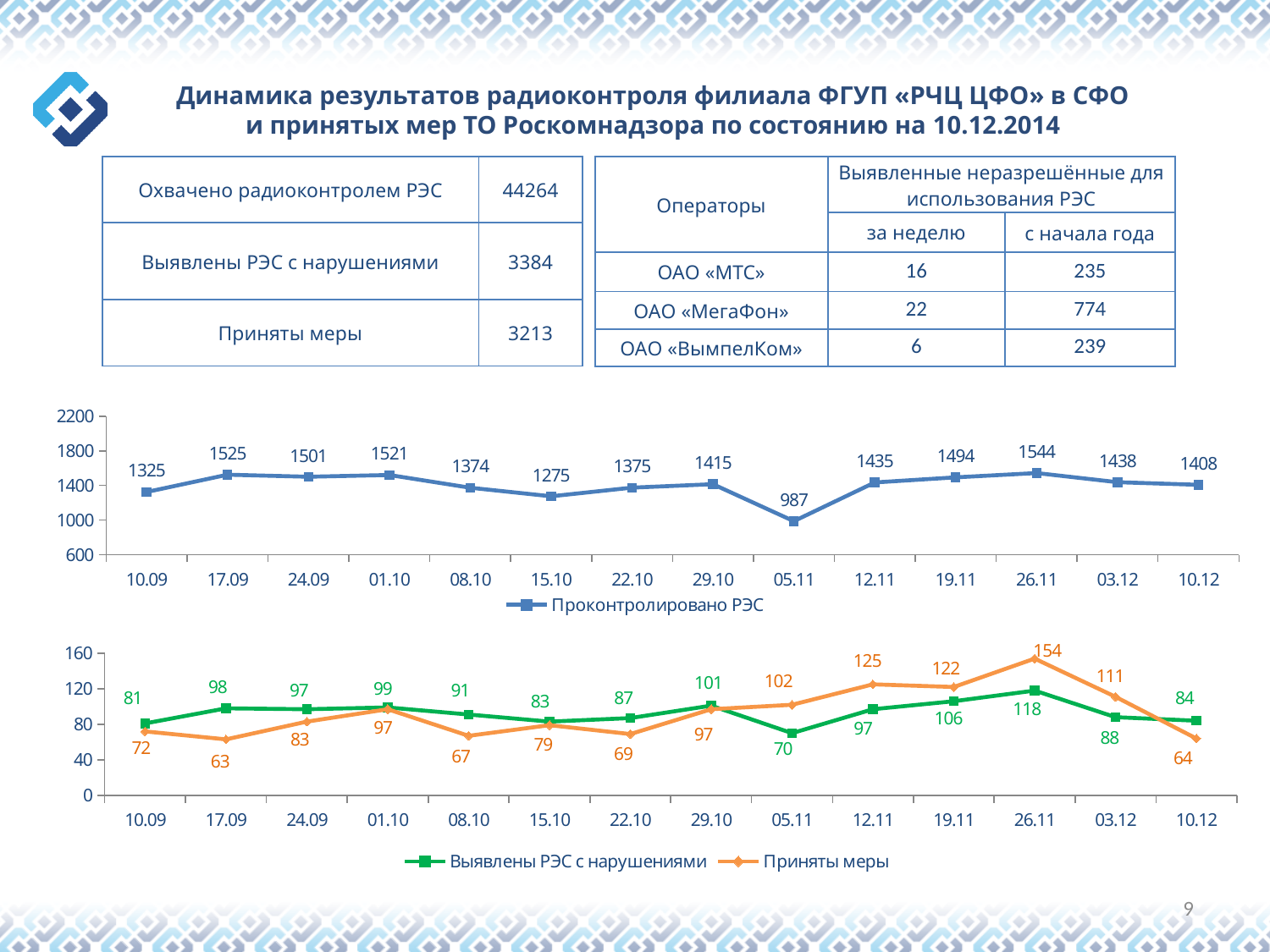
In the top chart (Проконтролировано РЭС), what is the difference between the values for 17.09 and 10.09? 200 In the top chart (Проконтролировано РЭС), which date has the highest value? 26.11 In the top chart (Проконтролировано РЭС), which date has the lowest value? 05.11 In the bottom chart, which date has the lowest value for Выявлены РЭС с нарушениями? 05.11 In the bottom chart, which is larger on 12.11: Выявлены РЭС с нарушениями or Приняты меры? Приняты меры In the top chart (Проконтролировано РЭС), how many data points are plotted? 14 How many series does the legend of the bottom chart list? 2 In the bottom chart, what is the value of Выявлены РЭС с нарушениями for 19.11? 106 In the bottom chart, what is the difference between Приняты меры and Выявлены РЭС с нарушениями on 26.11? 36 In the top chart (Проконтролировано РЭС), what is the value for 05.11? 987 In the bottom chart, what is the value of Приняты меры for 26.11? 154 What type of chart is the top chart? Line chart